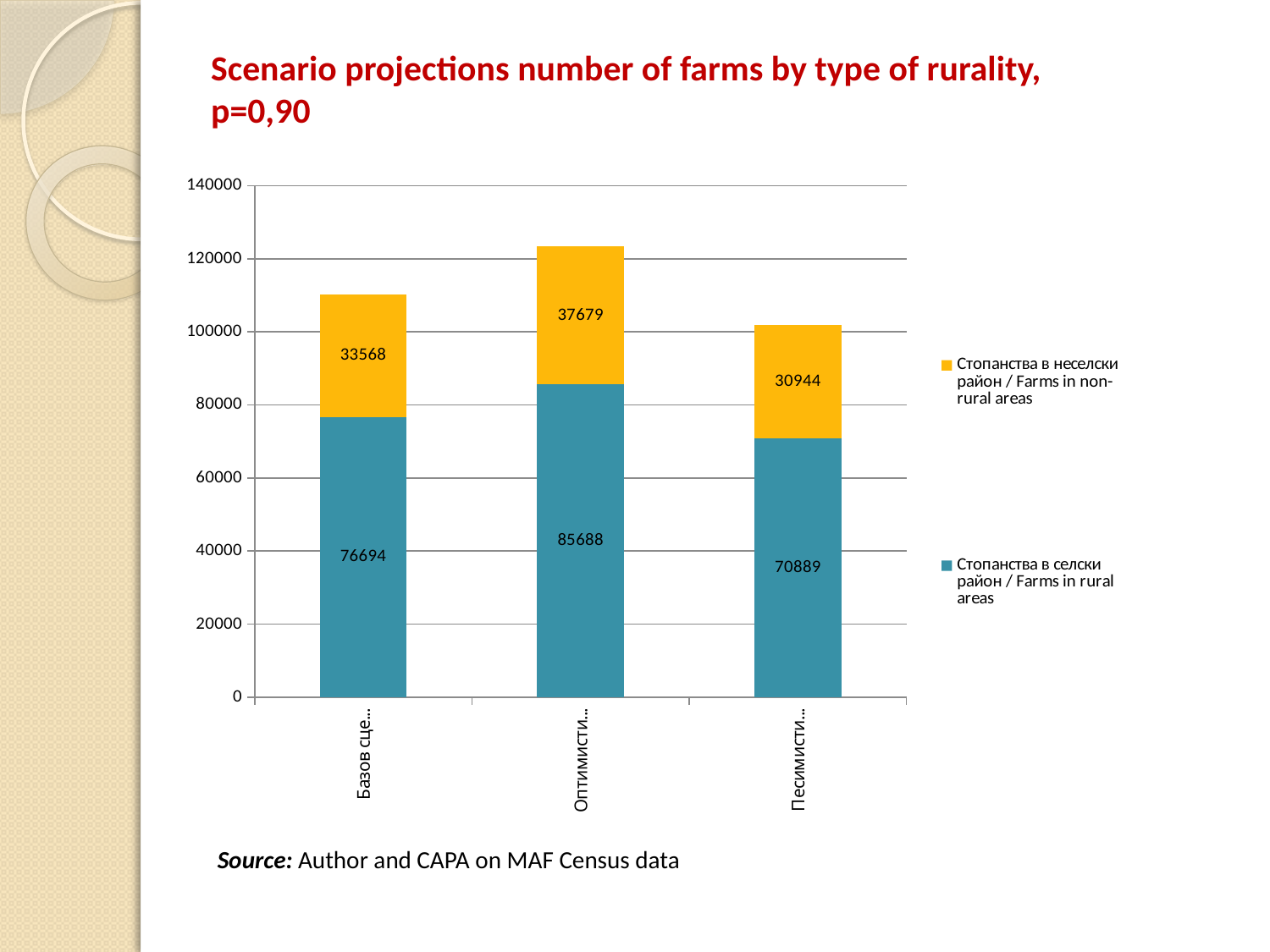
What type of chart is shown on the slide? Stacked bar chart How many series does the legend list? 2 Which bar has the lowest value for Farms in rural areas? Песимисти... (third bar) What is the total of the stacked bar for the first scenario (Базов сце...)? 110262 Which bar has the highest value for Farms in non-rural areas? Оптимисти... (second bar) How many bars (scenarios) are plotted on the chart? 3 What is the value for Farms in non-rural areas in the first bar (Базов сце...)? 33568 Is the value for Farms in non-rural areas in the third bar (Песимисти...) larger or smaller than in the first bar (Базов сце...)? smaller What is the difference between Farms in rural areas in the second bar (85688) and the third bar (70889)? 14799 Which colour represents Farms in rural areas in the chart? Blue (teal) What is the value for Farms in rural areas in the third bar (Песимисти...)? 70889 What is the value for Farms in rural areas in the second bar (Оптимисти...)? 85688